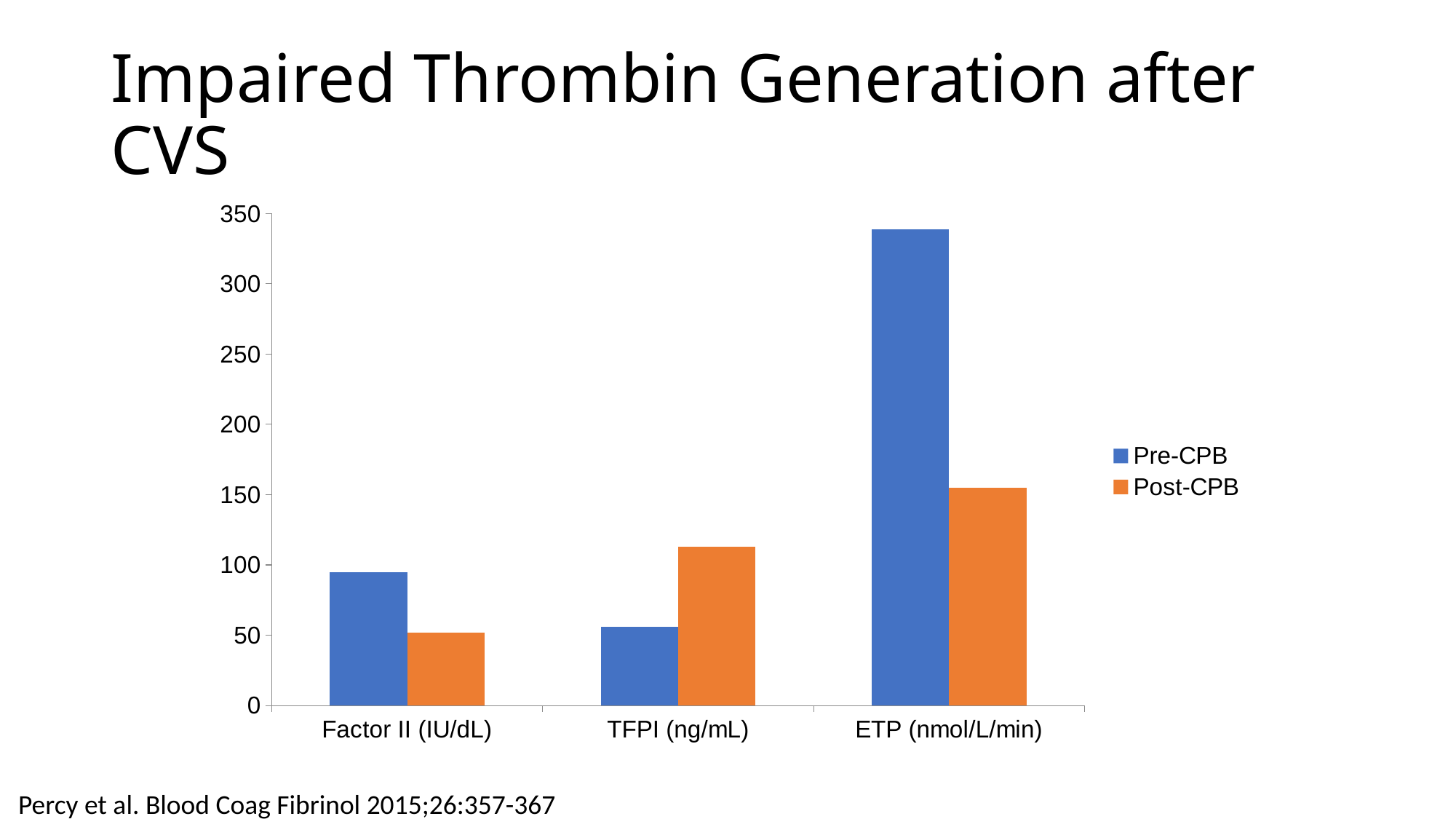
How many categories are shown on the x axis? 3 For Factor II (IU/dL), which is larger, the Pre-CPB or the Post-CPB value? Pre-CPB Is the Pre-CPB value for ETP (nmol/L/min) greater or less than 300? greater For TFPI (ng/mL), which is larger, the Pre-CPB or the Post-CPB value? Post-CPB Which category has the lowest Post-CPB value? Factor II (IU/dL) Is the Post-CPB value for TFPI (ng/mL) greater or less than 100? greater Which series is shown in orange in the legend? Post-CPB How many series does the legend list? 2 Is the Post-CPB value for ETP (nmol/L/min) greater or less than 200? less Which category has the highest Pre-CPB value? ETP (nmol/L/min) What kind of chart is shown on the slide? bar chart